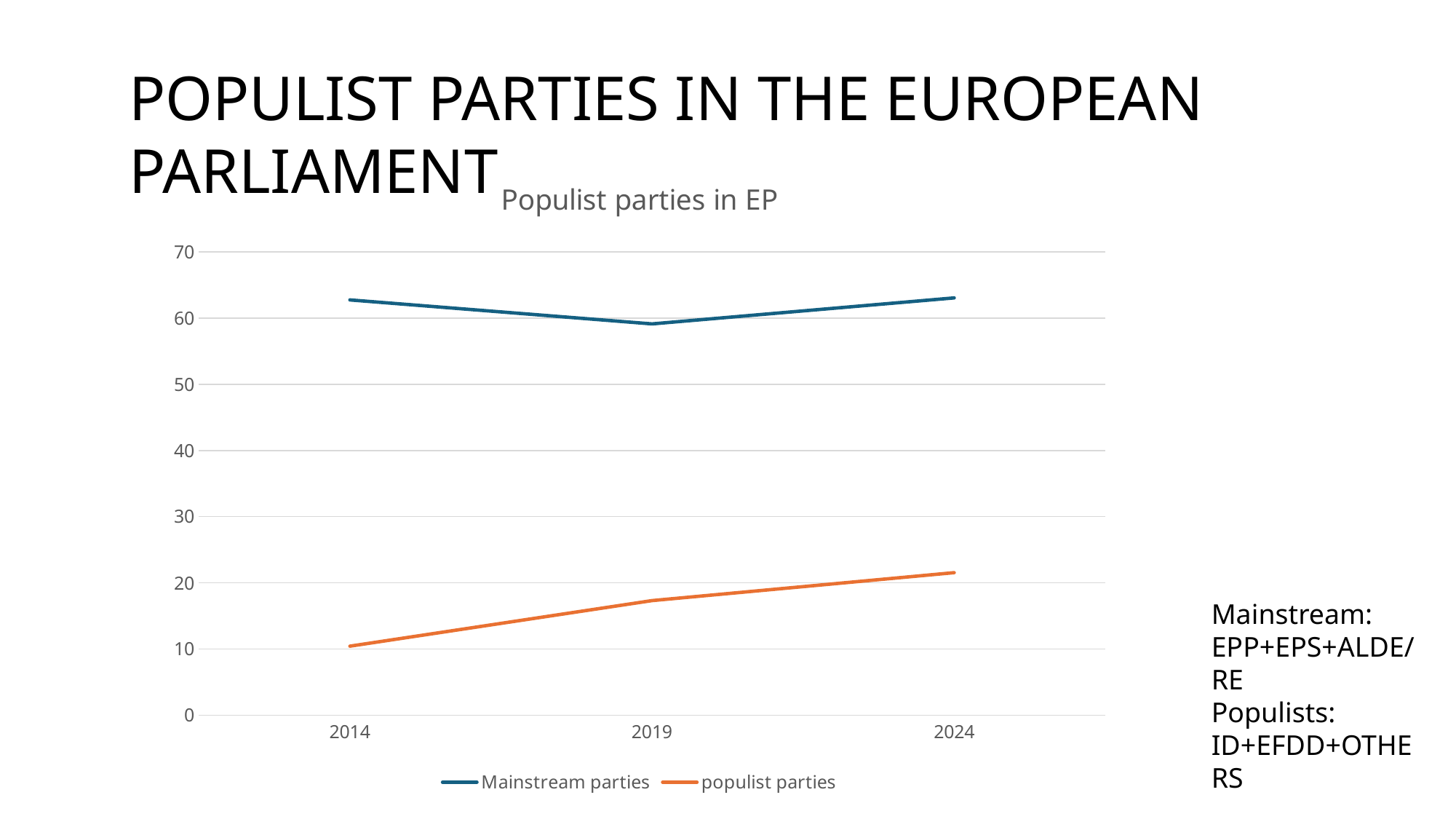
Does the populist parties line rise or fall from 2014 to 2024? rise Is the value for populist parties in 2014 greater or less than 20? less Which colour is used for the populist parties line? orange How many series does the legend list? 2 Which series has the higher value in 2024, Mainstream parties or populist parties? Mainstream parties Is the value for Mainstream parties in 2014 greater or less than 60? greater How many years are plotted on the x axis? 3 What is the title of the chart? Populist parties in EP In which year is the Mainstream parties value lowest? 2019 Is the value for populist parties in 2024 greater or less than 30? less In which year is the populist parties value lowest? 2014 What kind of chart is shown on the slide? line chart